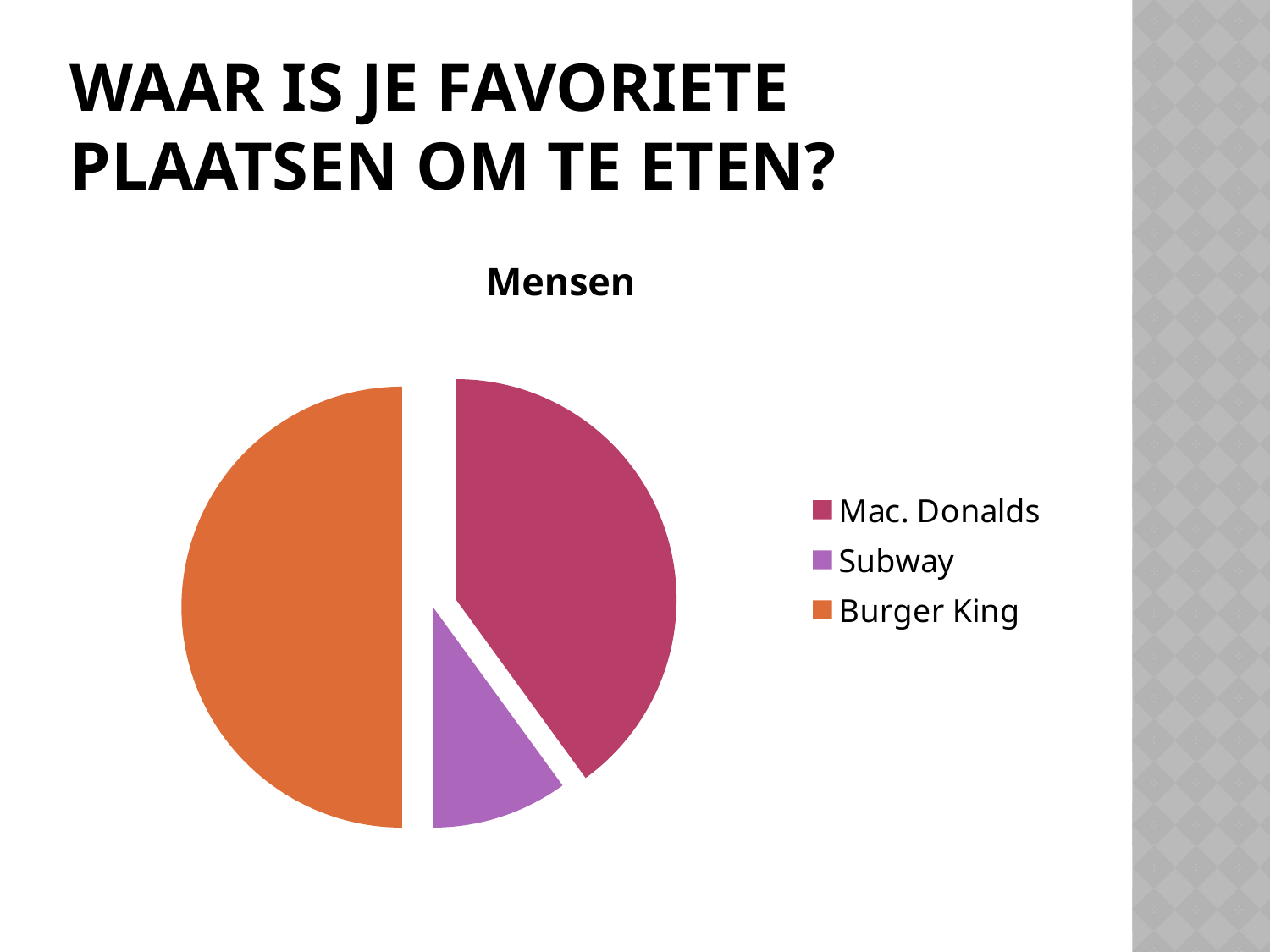
Which slice is larger, Mac. Donalds or Subway? Mac. Donalds How many entries does the legend list? 3 Which category has the largest slice of the pie? Burger King What kind of chart is shown on the slide? Pie chart Which slice is larger, Burger King or Subway? Burger King What is the title of the chart? Mensen How many slices does the pie chart have? 3 Which category has the smallest slice of the pie? Subway Which slice is larger, Burger King or Mac. Donalds? Burger King What colour is the Subway slice in the pie chart? Purple